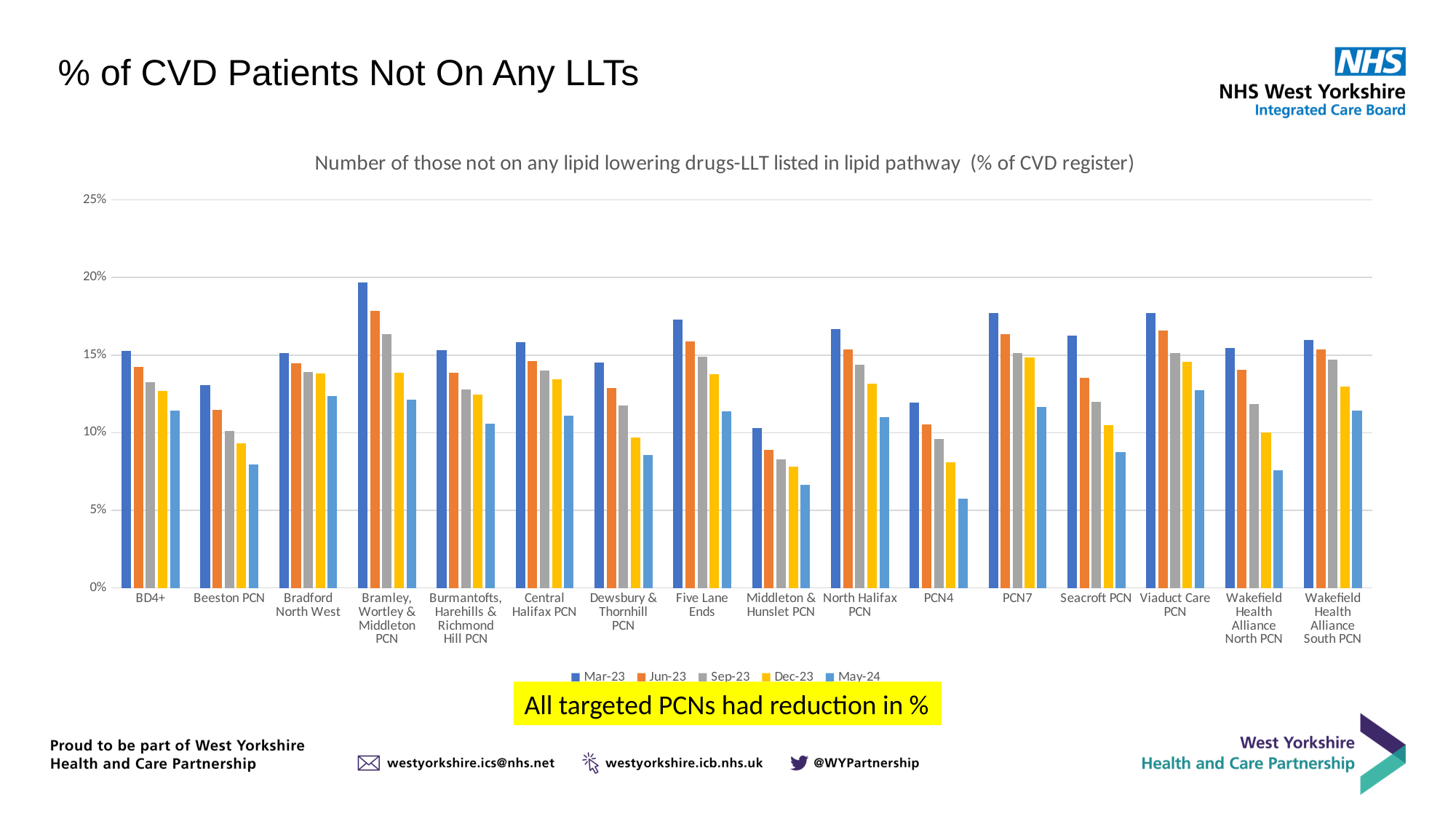
Is the May-24 value for Middleton & Hunslet PCN greater or less than 10%? less For Bramley, Wortley & Middleton PCN, do the values rise or fall from Mar-23 to May-24? Fall Which is larger: the Mar-23 value for Five Lane Ends or the Mar-23 value for Middleton & Hunslet PCN? Five Lane Ends How many PCNs (categories) are shown on the x axis of the chart? 16 Which PCN has the lowest May-24 value? PCN4 Which PCN has the lowest Mar-23 value? Middleton & Hunslet PCN How many series does the chart legend list? 5 What kind of chart is shown on the slide? Bar chart Is the Mar-23 value for Bramley, Wortley & Middleton PCN greater or less than 15%? greater Which PCN has the highest Mar-23 value? Bramley, Wortley & Middleton PCN Which series is listed first in the chart legend? Mar-23 Is the Mar-23 value for Beeston PCN greater or less than 10%? greater